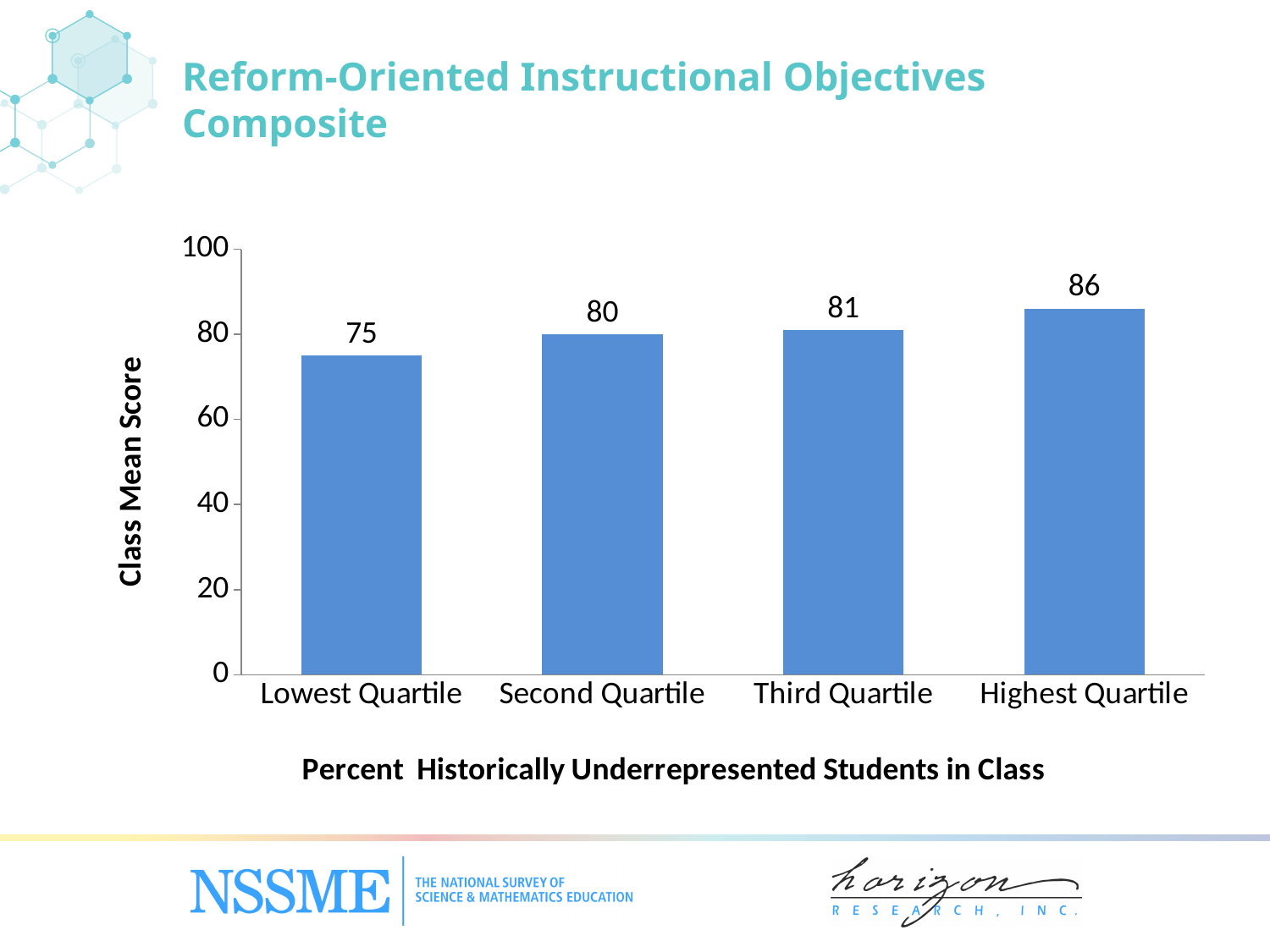
What is the class mean score for the Lowest Quartile? 75 Do the class mean scores rise or fall from the Lowest Quartile to the Highest Quartile? Rise Which quartile has the highest class mean score? Highest Quartile What is the class mean score for the Third Quartile? 81 Which quartile has the lowest class mean score? Lowest Quartile What is the class mean score for the Second Quartile? 80 How many quartile categories are shown on the x axis? 4 What kind of chart is shown on the slide? Bar chart What is the difference between the class mean scores of the Highest Quartile and the Lowest Quartile? 11 Which has a larger class mean score, the Second Quartile or the Highest Quartile? Highest Quartile What is the class mean score for the Highest Quartile? 86 What is the title of the chart on the slide? Reform-Oriented Instructional Objectives Composite